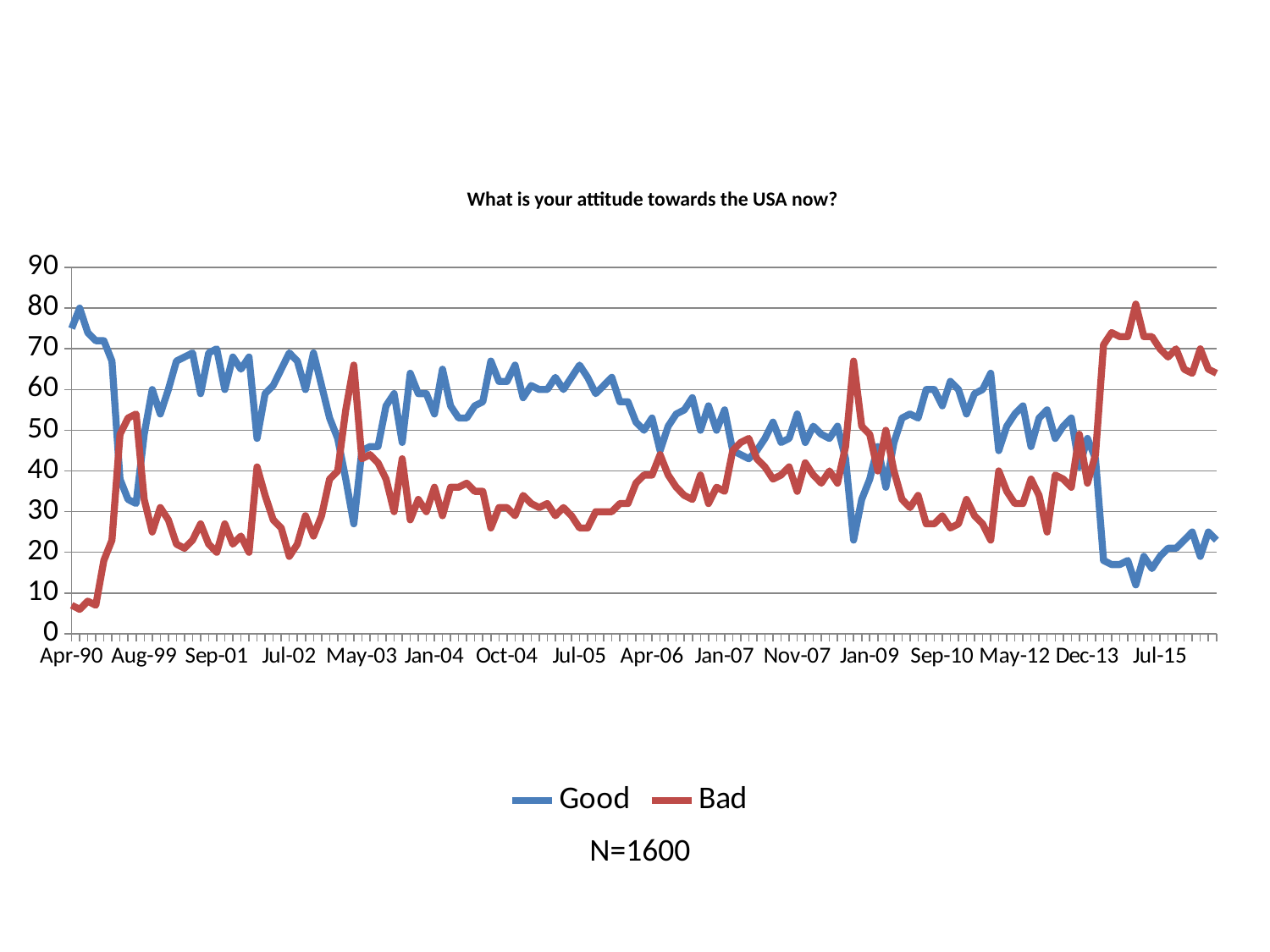
Does the Good series rise or fall between Dec-13 and Jul-15? fall Is the value for Bad at Apr-90 greater or less than 10? less Is the value for Good at Apr-90 greater or less than 70? greater What is the title of the chart? What is your attitude towards the USA now? At Apr-90, which series has the larger value, Good or Bad? Good At Jul-15, which series has the larger value, Good or Bad? Bad Is the value for Bad at Jan-04 greater or less than 40? less What kind of chart is shown on the slide? line chart How many series does the legend list? 2 Which colour is used for the Bad series? red